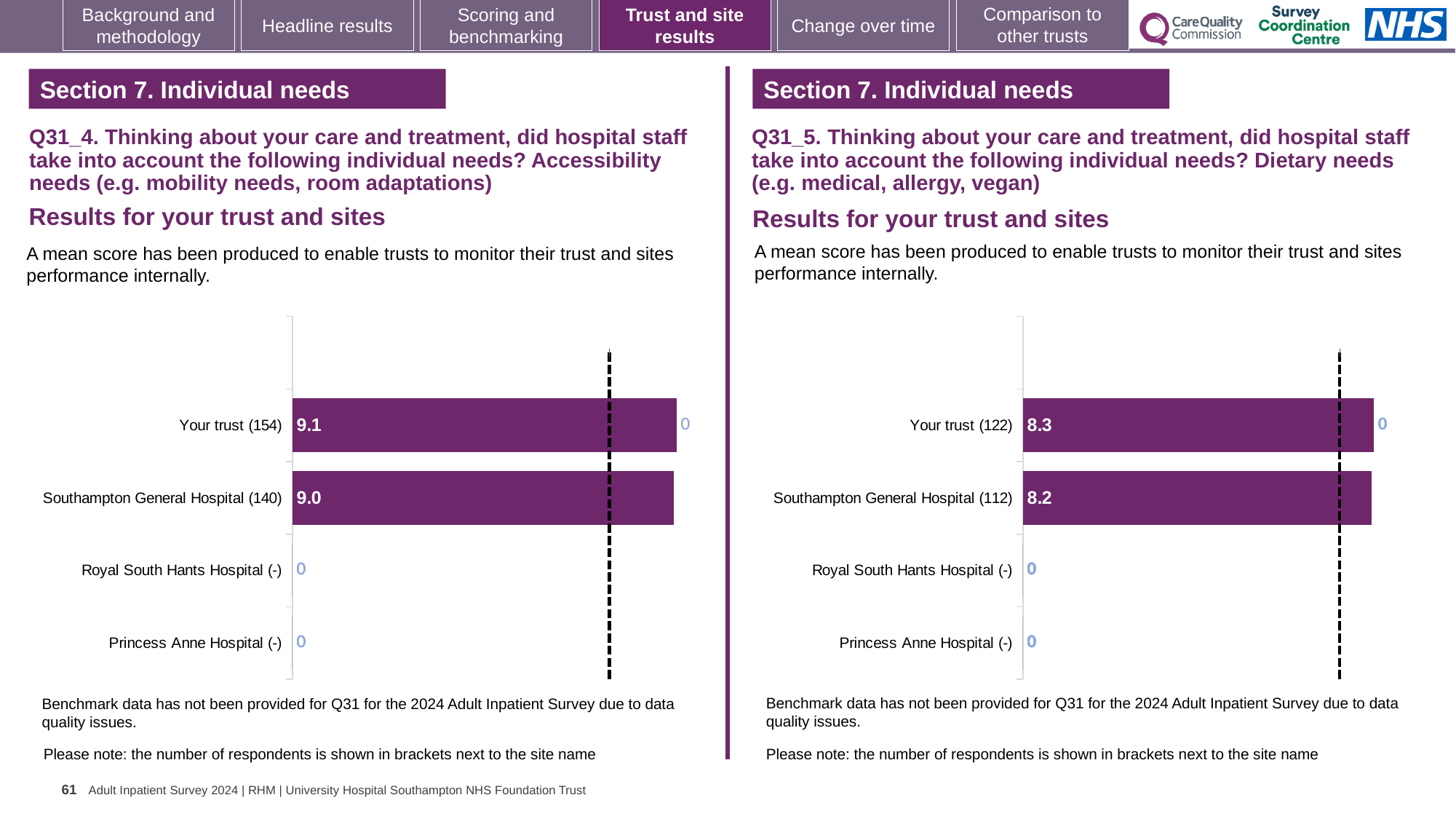
On the Q31_5 Dietary needs chart (right), which category has the highest mean score? Your trust (122) On the Q31_5 Dietary needs chart (right), what is the mean score for Your trust (122)? 8.3 What kind of chart is used on the Q31_5 Dietary needs chart (right)? Bar chart On the Q31_4 Accessibility needs chart (left), what value is shown for Royal South Hants Hospital (-)? 0 On the Q31_4 Accessibility needs chart (left), which category has the highest mean score? Your trust (154) On the Q31_5 Dietary needs chart (right), what is the difference between the scores for Your trust (122) and Southampton General Hospital (112)? 0.1 On the Q31_4 Accessibility needs chart (left), what is the difference between the scores for Your trust (154) and Southampton General Hospital (140)? 0.1 On the Q31_4 Accessibility needs chart (left), what is the mean score for Your trust (154)? 9.1 On the Q31_5 Dietary needs chart (right), which is larger: the score for Your trust (122) or for Southampton General Hospital (112)? Your trust (122) On the Q31_4 Accessibility needs chart (left), what is the mean score for Southampton General Hospital (140)? 9.0 How many categories are shown on the Q31_4 Accessibility needs chart (left)? 4 On the Q31_5 Dietary needs chart (right), what is the mean score for Southampton General Hospital (112)? 8.2